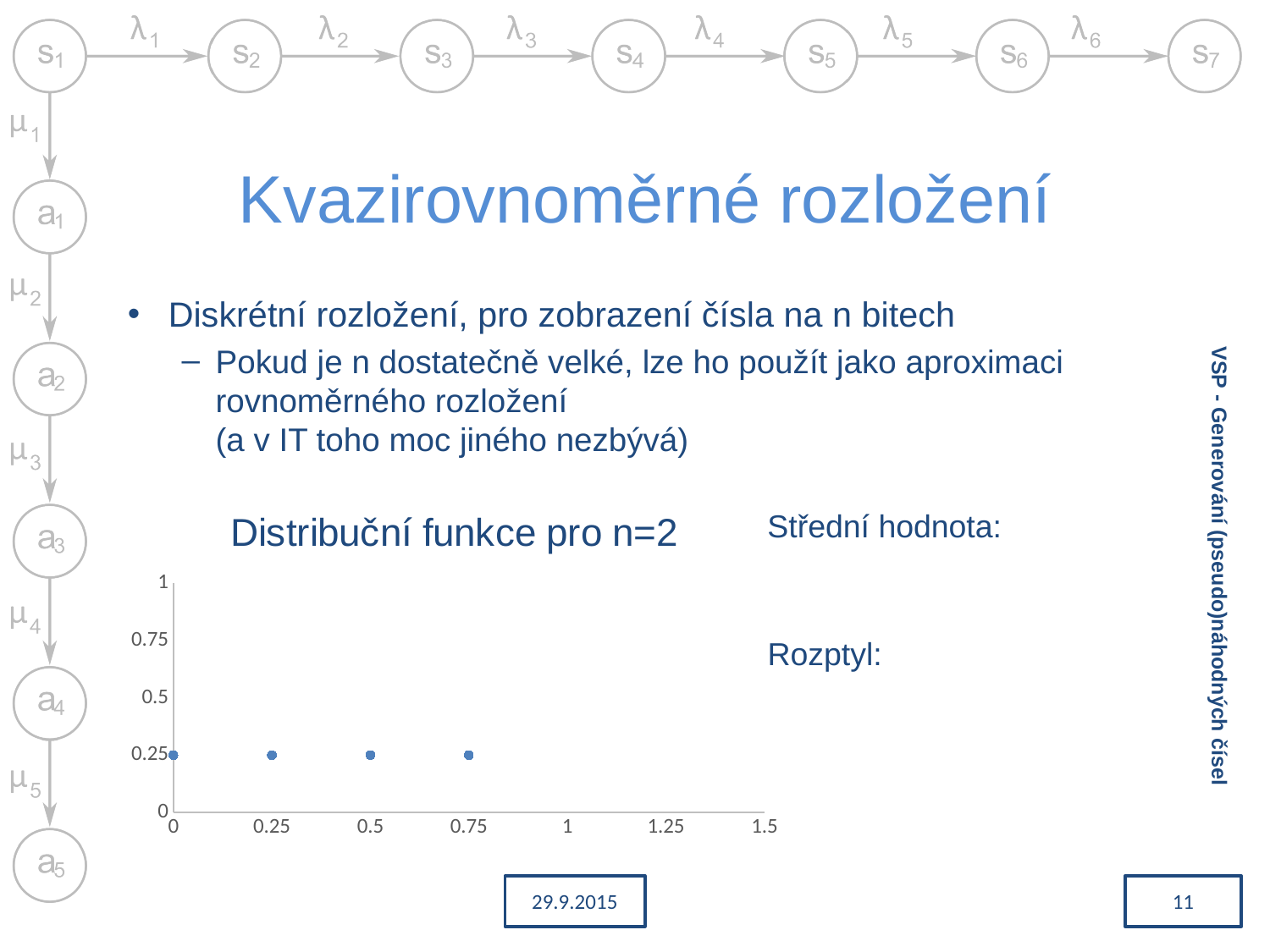
What is the largest x value at which a point is plotted? 0.75 What is the y value of the point at x = 0.75? 0.25 What is the title of the chart on the slide? Distribuční funkce pro n=2 What is the y value of the point at x = 0.5? 0.25 What is the difference between the y values of the points at x = 0 and x = 0.75? 0 Do the plotted values rise, fall, or stay flat as x increases? stay flat What kind of chart is shown on the slide? scatter chart Is the value of the point at x = 0.25 greater or less than 0.5? less What is the highest value shown on the y axis? 1 What is the y value of the point at x = 0? 0.25 How many data points are plotted in the chart? 4